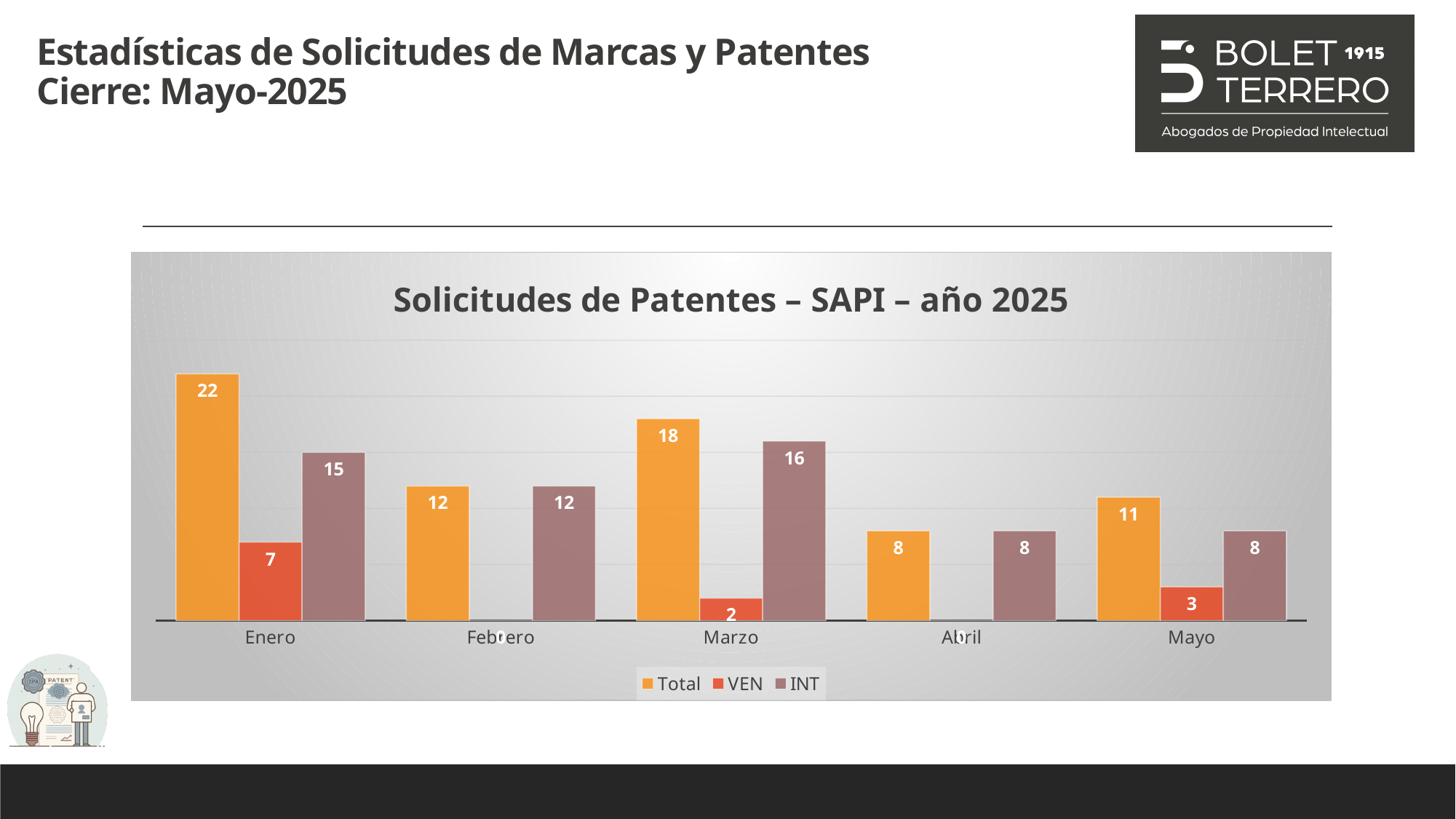
What is the VEN value for Mayo? 3 What is the INT value for Marzo? 16 Which is larger, the INT value for Enero or the INT value for Marzo? Marzo How many series does the legend list? 3 What is the title of the chart? Solicitudes de Patentes – SAPI – año 2025 Which series is shown in orange? Total What is the Total value for Enero? 22 What is the difference between the Total values for Enero and Marzo? 4 Which month has the lowest Total value? Abril What kind of chart is shown? Bar chart How many months are shown on the x axis? 5 Which month has the highest Total value? Enero